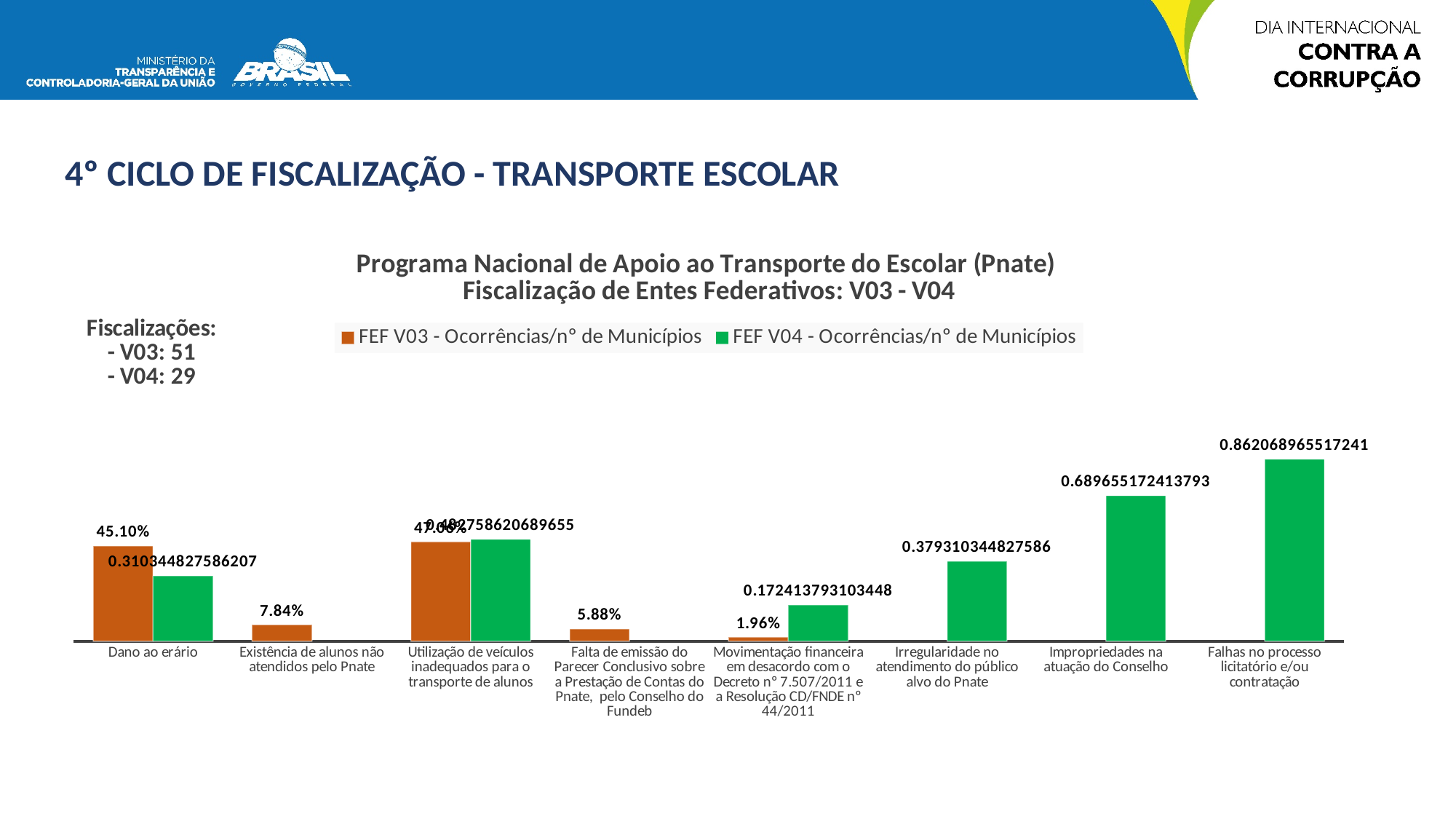
What is the FEF V04 value for 'Falhas no processo licitatório e/ou contratação'? 0.862068965517241 Which category has the lowest FEF V03 value among those with a V03 bar? Movimentação financeira em desacordo com o Decreto n° 7.507/2011 e a Resolução CD/FNDE n° 44/2011 What is the FEF V03 value for 'Existência de alunos não atendidos pelo Pnate'? 7.84% How many series does the chart legend list? 2 What is the difference between the FEF V03 values for 'Dano ao erário' and 'Existência de alunos não atendidos pelo Pnate'? 37.26% How many categories are shown on the x axis of the chart? 8 Which has the larger FEF V04 value: 'Impropriedades na atuação do Conselho' or 'Irregularidade no atendimento do público alvo do Pnate'? Impropriedades na atuação do Conselho What kind of chart is shown on the slide? Bar chart Which category has the highest FEF V04 value? Falhas no processo licitatório e/ou contratação What is the FEF V04 value for 'Impropriedades na atuação do Conselho'? 0.689655172413793 What is the FEF V03 value for 'Dano ao erário'? 45.10% What is the FEF V03 value for 'Movimentação financeira em desacordo com o Decreto n° 7.507/2011 e a Resolução CD/FNDE n° 44/2011'? 1.96%